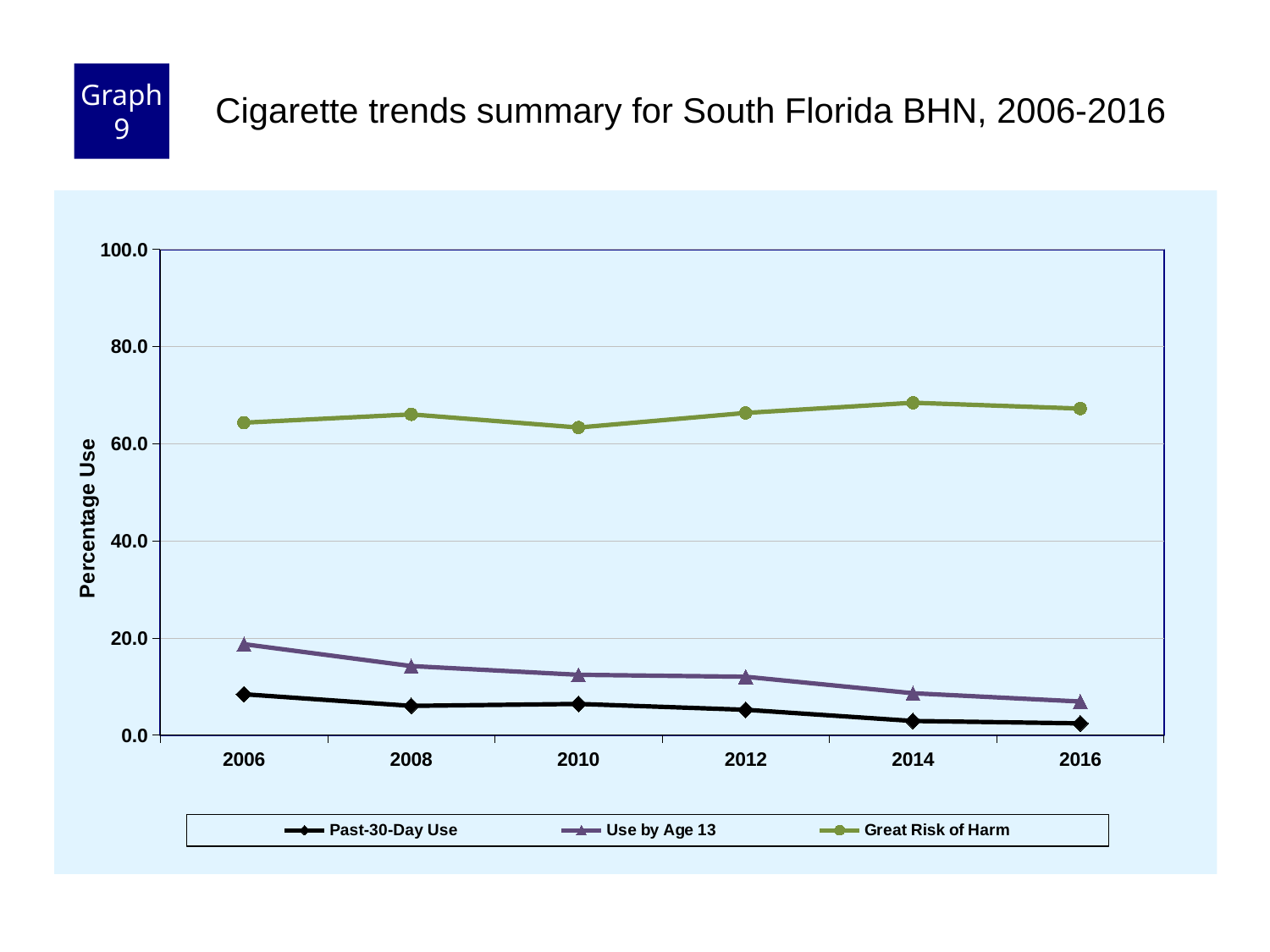
Does the Past-30-Day Use series generally rise or fall from 2006 to 2016? Fall Is the value for Great Risk of Harm in 2006 greater or less than 60? greater How many series does the legend list? 3 In which year is the Use by Age 13 series highest? 2006 Is the value for Use by Age 13 in 2016 greater or less than 20? less What kind of chart is shown on the slide? Line chart Is the value for Great Risk of Harm in 2014 greater or less than 80? less What is the label on the y axis? Percentage Use In which year is the Past-30-Day Use series highest? 2006 In 2012, which is larger: Great Risk of Harm or Use by Age 13? Great Risk of Harm Does the Use by Age 13 series rise or fall from 2006 to 2016? Fall How many years are plotted along the x axis? 6